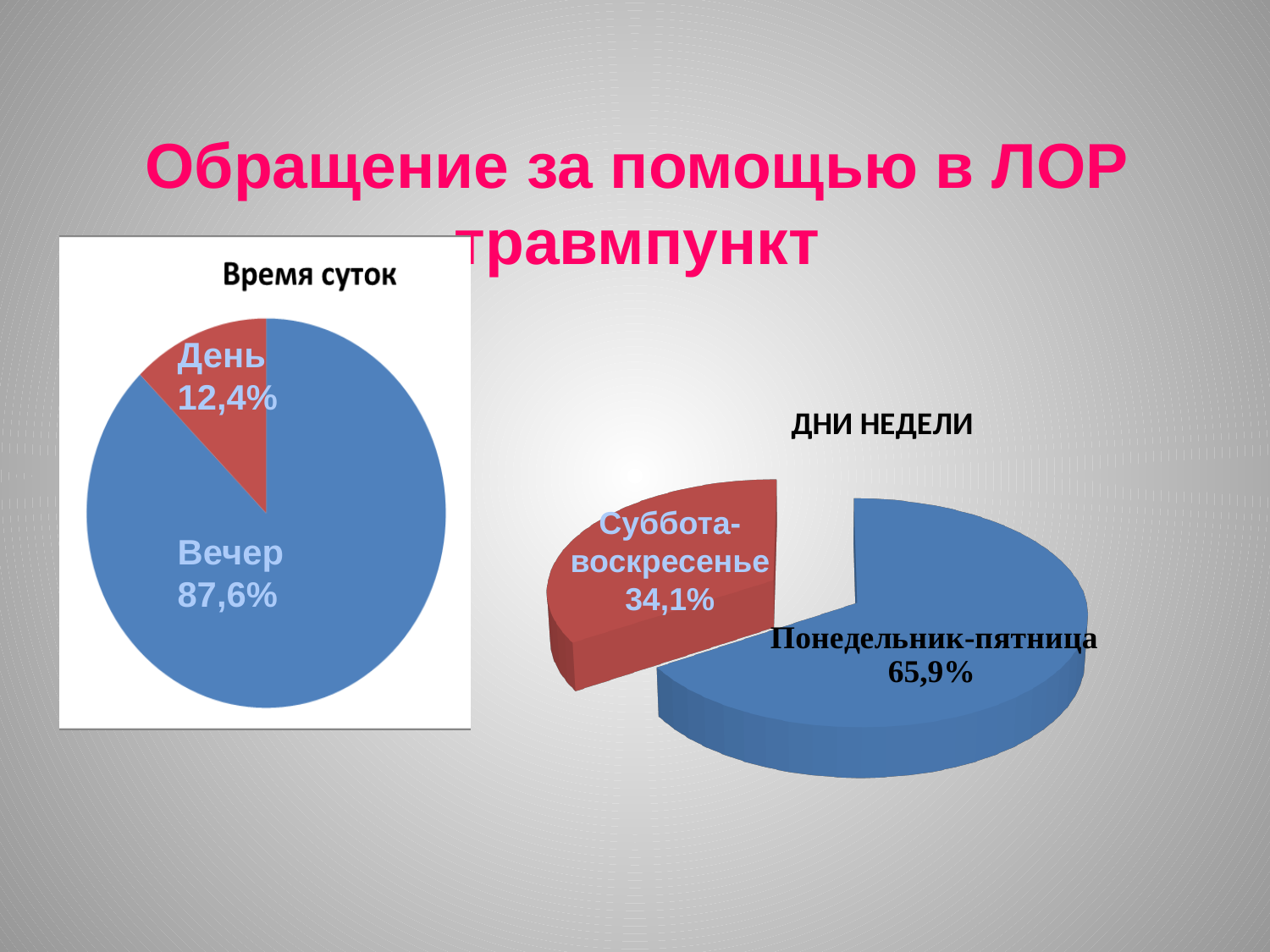
In the 'Время суток' chart, what share is labelled for 'День'? 12,4% How many slices does the 'ДНИ НЕДЕЛИ' chart have? 2 In the 'ДНИ НЕДЕЛИ' chart, what is the difference between the 'Понедельник-пятница' and 'Суббота-воскресенье' shares? 31,8% In the 'ДНИ НЕДЕЛИ' chart, what share is labelled for 'Понедельник-пятница'? 65,9% What type of chart is the 'Время суток' chart? Pie chart In the 'Время суток' chart, which category has the smallest slice? День In the 'ДНИ НЕДЕЛИ' chart, what share is labelled for 'Суббота-воскресенье'? 34,1% In the 'ДНИ НЕДЕЛИ' chart, what colour is the 'Суббота-воскресенье' slice? Red In the 'ДНИ НЕДЕЛИ' chart, which category has the larger slice? Понедельник-пятница In the 'Время суток' chart, what share is labelled for 'Вечер'? 87,6% In the 'Время суток' chart, which category has the largest slice? Вечер In the 'Время суток' chart, what is the difference between the 'Вечер' and 'День' shares? 75,2%